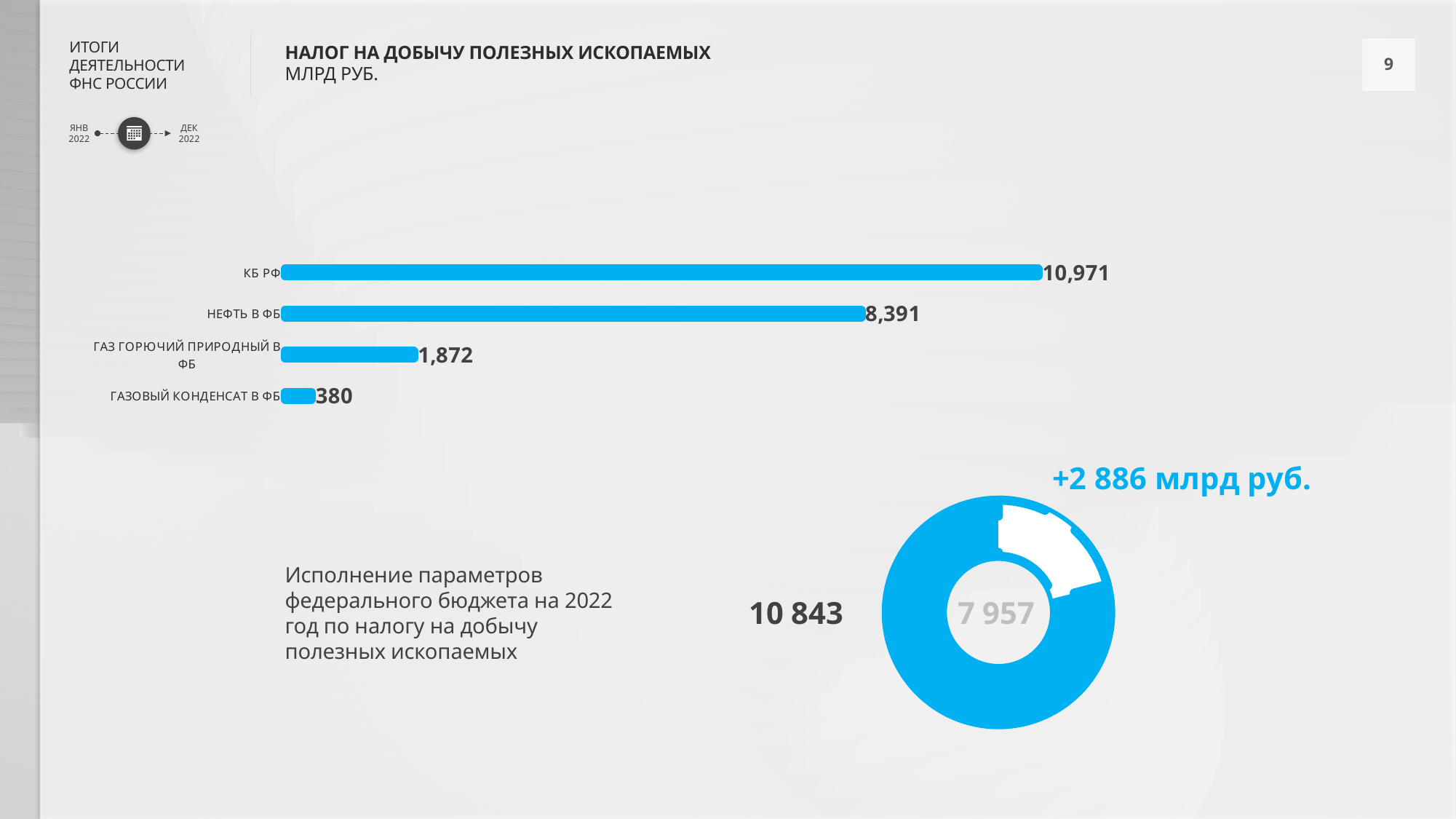
In the bar chart, what is the value for ГАЗОВЫЙ КОНДЕНСАТ В ФБ? 380 In the bar chart, what is the difference between the values for КБ РФ and НЕФТЬ В ФБ? 2,580 In the bar chart, which category has the highest value? КБ РФ What kind of chart is the chart at the top of the slide? Bar chart In the bar chart, what is the difference between the values for ГАЗ ГОРЮЧИЙ ПРИРОДНЫЙ В ФБ and ГАЗОВЫЙ КОНДЕНСАТ В ФБ? 1,492 How many categories does the bar chart show? 4 In the bar chart, which category has the lowest value? ГАЗОВЫЙ КОНДЕНСАТ В ФБ In the bar chart, which is larger: the value for НЕФТЬ В ФБ or the value for ГАЗ ГОРЮЧИЙ ПРИРОДНЫЙ В ФБ? НЕФТЬ В ФБ What is the title of the bar chart at the top of the slide? НАЛОГ НА ДОБЫЧУ ПОЛЕЗНЫХ ИСКОПАЕМЫХ In the bar chart, what is the value for НЕФТЬ В ФБ? 8,391 In the bar chart, what is the value for ГАЗ ГОРЮЧИЙ ПРИРОДНЫЙ В ФБ? 1,872 In the bar chart, what is the value for КБ РФ? 10,971